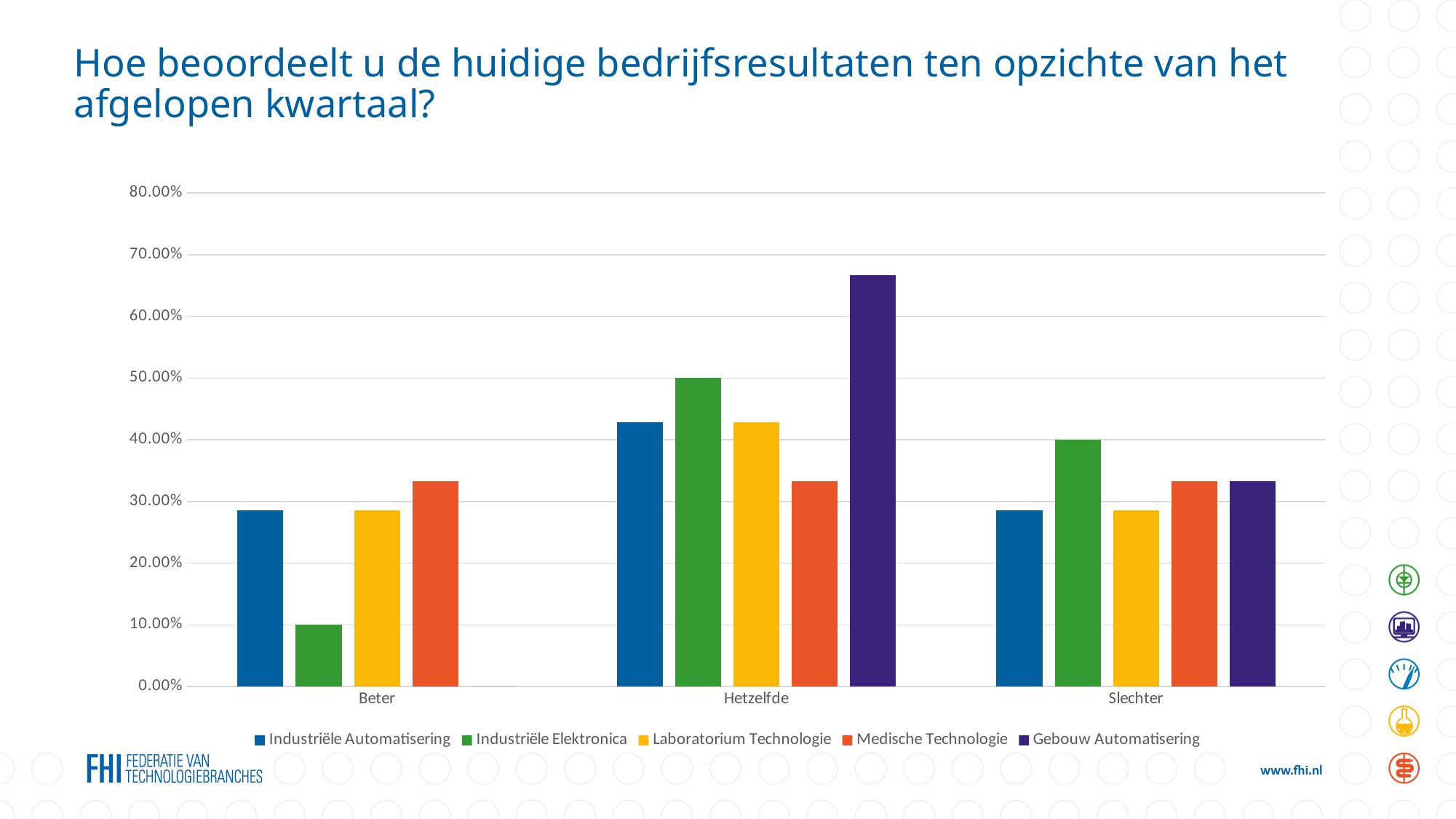
What is the value for Industriële Elektronica in the Beter category? 10.00% Which series has the highest value in the Slechter category? Industriële Elektronica Which series has the highest value in the Hetzelfde category? Gebouw Automatisering In the Hetzelfde category, which is larger: Gebouw Automatisering or Medische Technologie? Gebouw Automatisering What is the value for Industriële Elektronica in the Hetzelfde category? 50.00% How many series does the legend list? 5 What kind of chart is shown on the slide? bar chart What is the value for Industriële Elektronica in the Slechter category? 40.00% What is the difference between the Industriële Elektronica values for Hetzelfde and Beter? 40.00% Is the value for Gebouw Automatisering in the Hetzelfde category greater or less than 60.00%? greater How many categories are shown on the x axis? 3